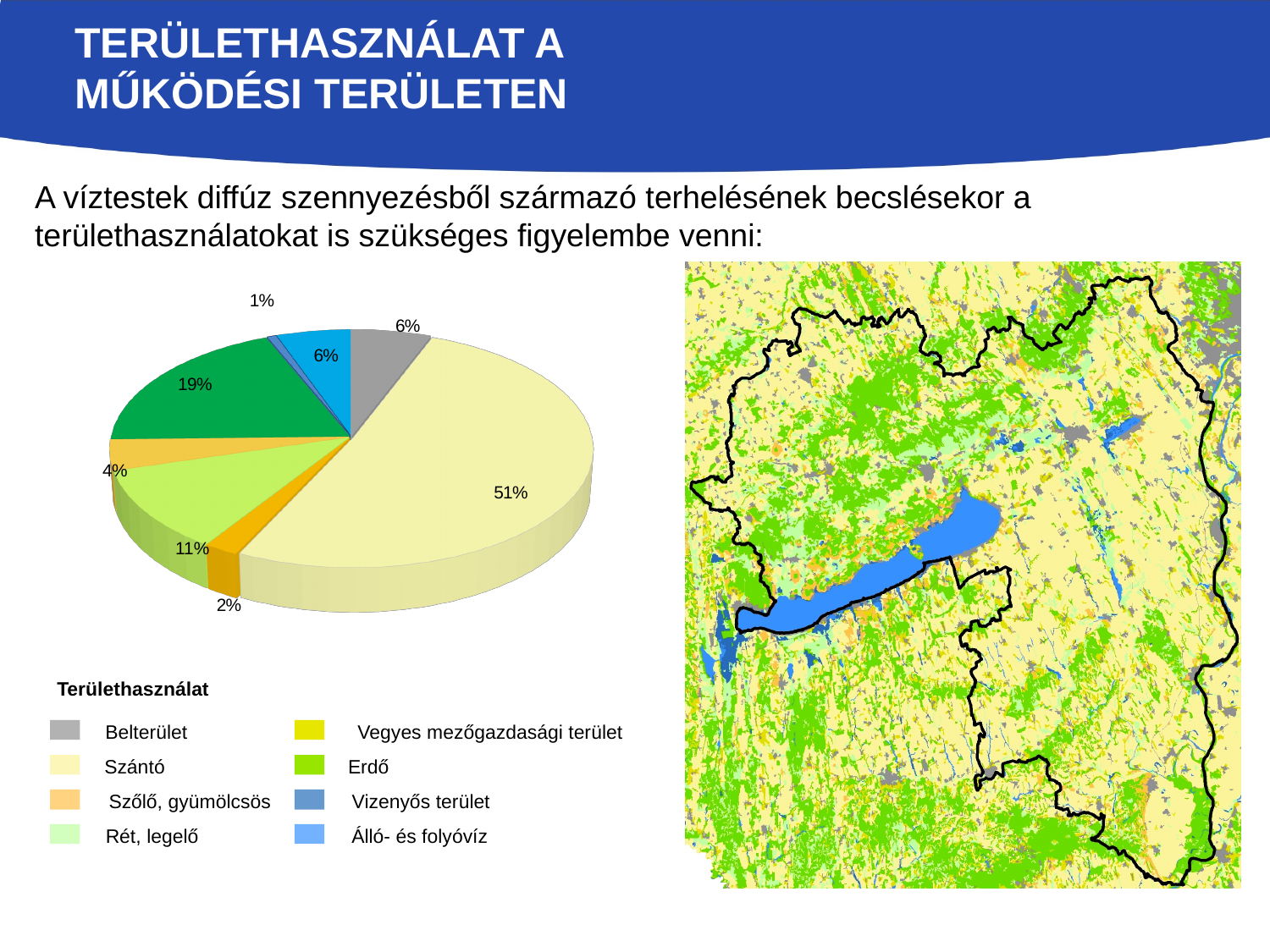
What share does Rét, legelő have in the pie chart? 11% What is the difference in percentage points between Szántó and Erdő in the pie chart? 32 Which land-use category has the largest slice in the pie chart? Szántó What kind of chart is shown on the slide? Pie chart What share of the pie chart does Szántó represent? 51% What share of the pie chart is Vizenyős terület? 1% Which is larger in the pie chart, Erdő or Rét, legelő? Erdő Which land-use category has the smallest slice in the pie chart? Vizenyős terület What percentage is shown for Belterület in the pie chart? 6% What is the title of the chart's legend? Területhasználat What percentage of the pie chart is Erdő? 19% How many slices does the pie chart have? 8